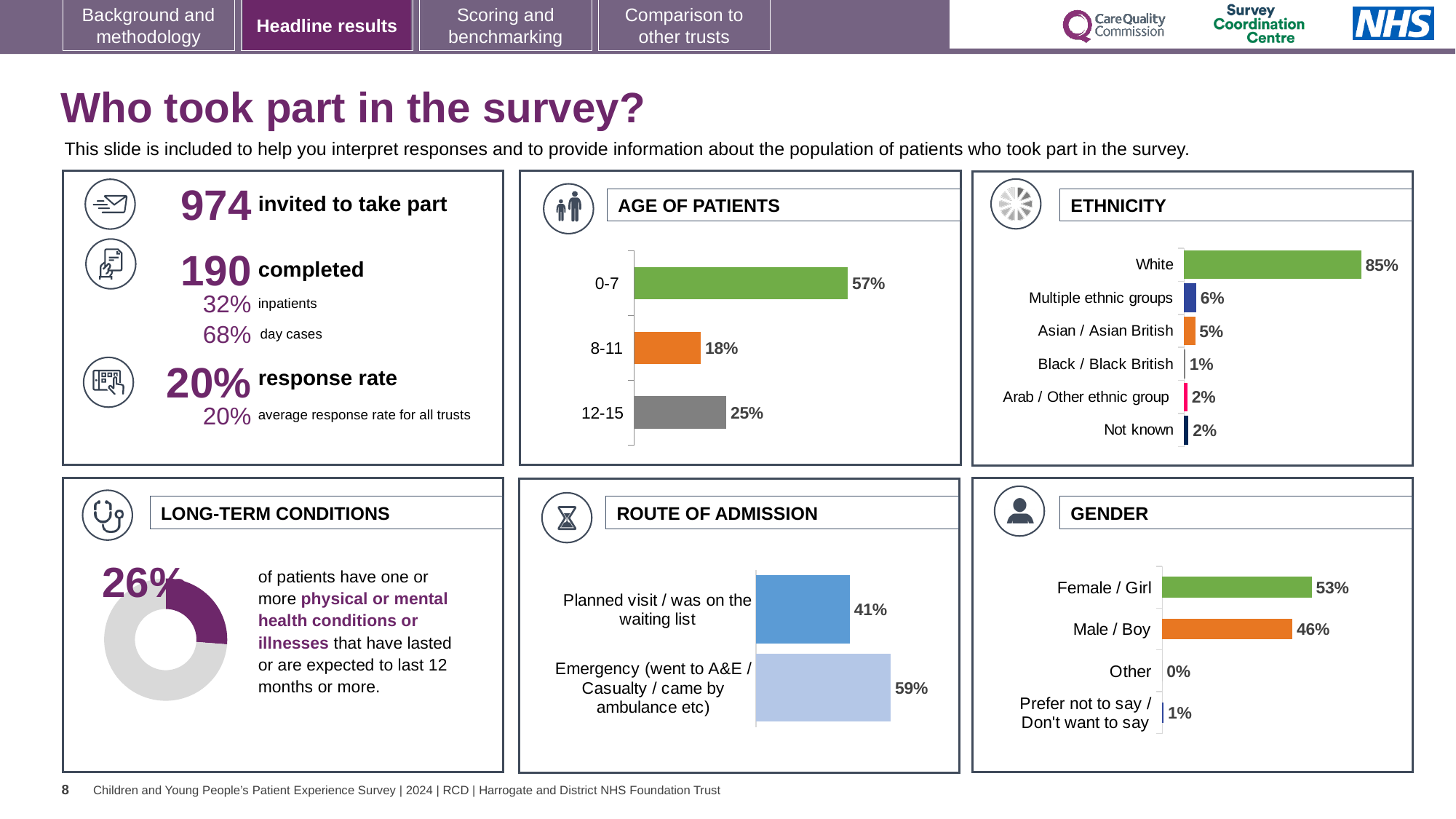
In the AGE OF PATIENTS chart, what percentage of patients were aged 0-7? 57% In the ROUTE OF ADMISSION chart, what percentage of patients came via Emergency? 59% In the AGE OF PATIENTS chart, which age group has the lowest percentage? 8-11 In the GENDER chart, what percentage of patients were Male / Boy? 46% In the GENDER chart, which category has the highest percentage? Female / Girl In the ROUTE OF ADMISSION chart, what is the difference between the Emergency and Planned visit percentages? 18% How many ethnicity categories are shown in the ETHNICITY chart? 6 In the ETHNICITY chart, what percentage of patients were White? 85% In the AGE OF PATIENTS chart, what is the difference between the 0-7 and 12-15 percentages? 32% What kind of chart is used in the LONG-TERM CONDITIONS panel? Doughnut chart In the ETHNICITY chart, which category has the lowest percentage? Black / Black British In the ETHNICITY chart, which is larger: Multiple ethnic groups or Asian / Asian British? Multiple ethnic groups